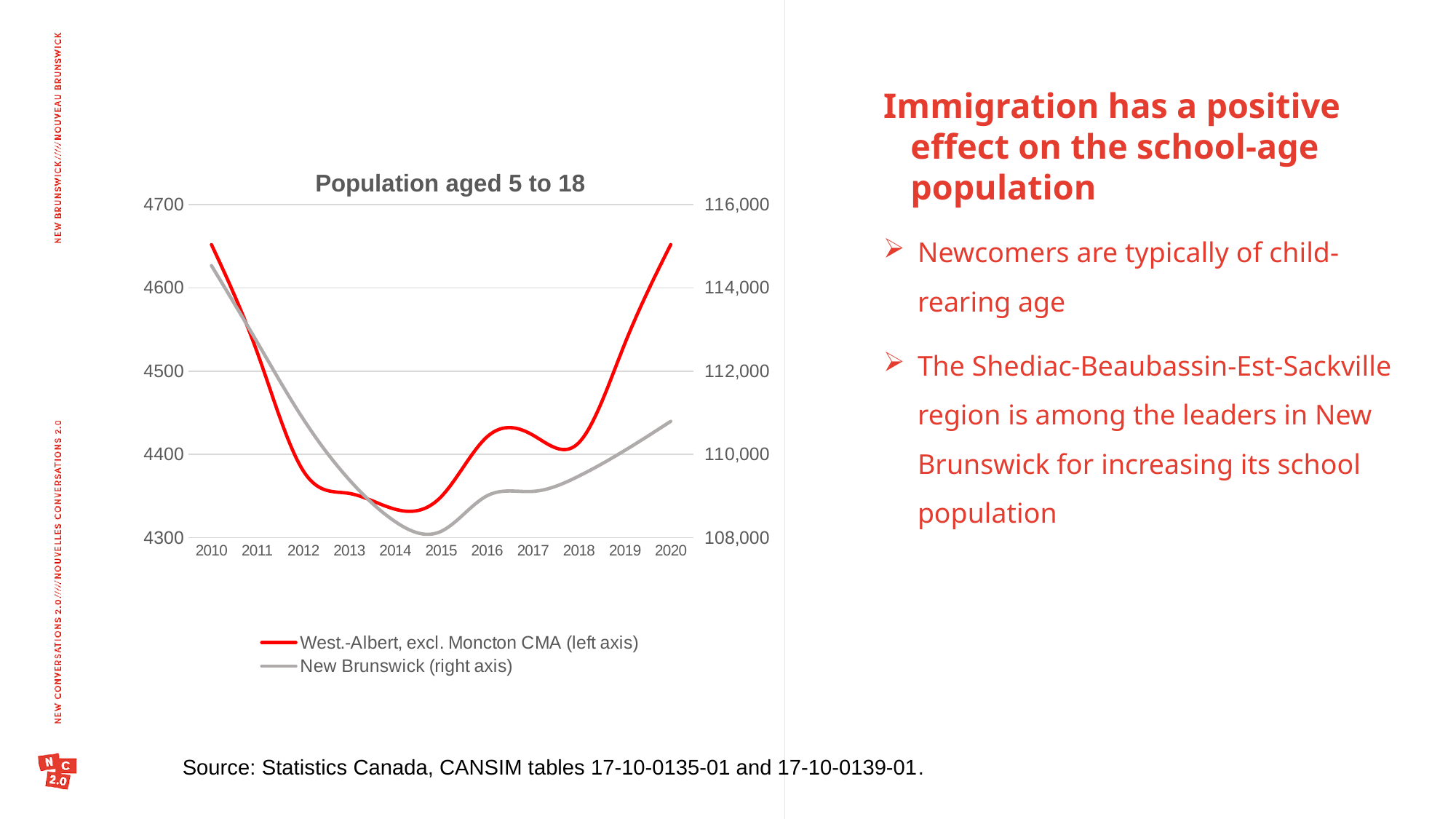
Does the West.-Albert, excl. Moncton CMA series rise or fall from 2018 to 2020? rise In which year is the New Brunswick series at its highest? 2010 In which year is the New Brunswick series at its lowest? 2015 Is the value for New Brunswick in 2010 greater or less than 114,000? greater How many series does the legend list? 2 Is the value for West.-Albert, excl. Moncton CMA in 2010 greater or less than 4600? greater What is the title of the chart? Population aged 5 to 18 Is the value for New Brunswick in 2015 greater or less than 110,000? less How many years are plotted along the x axis? 11 Which series is plotted against the right axis? New Brunswick What kind of chart is shown on the slide? line chart